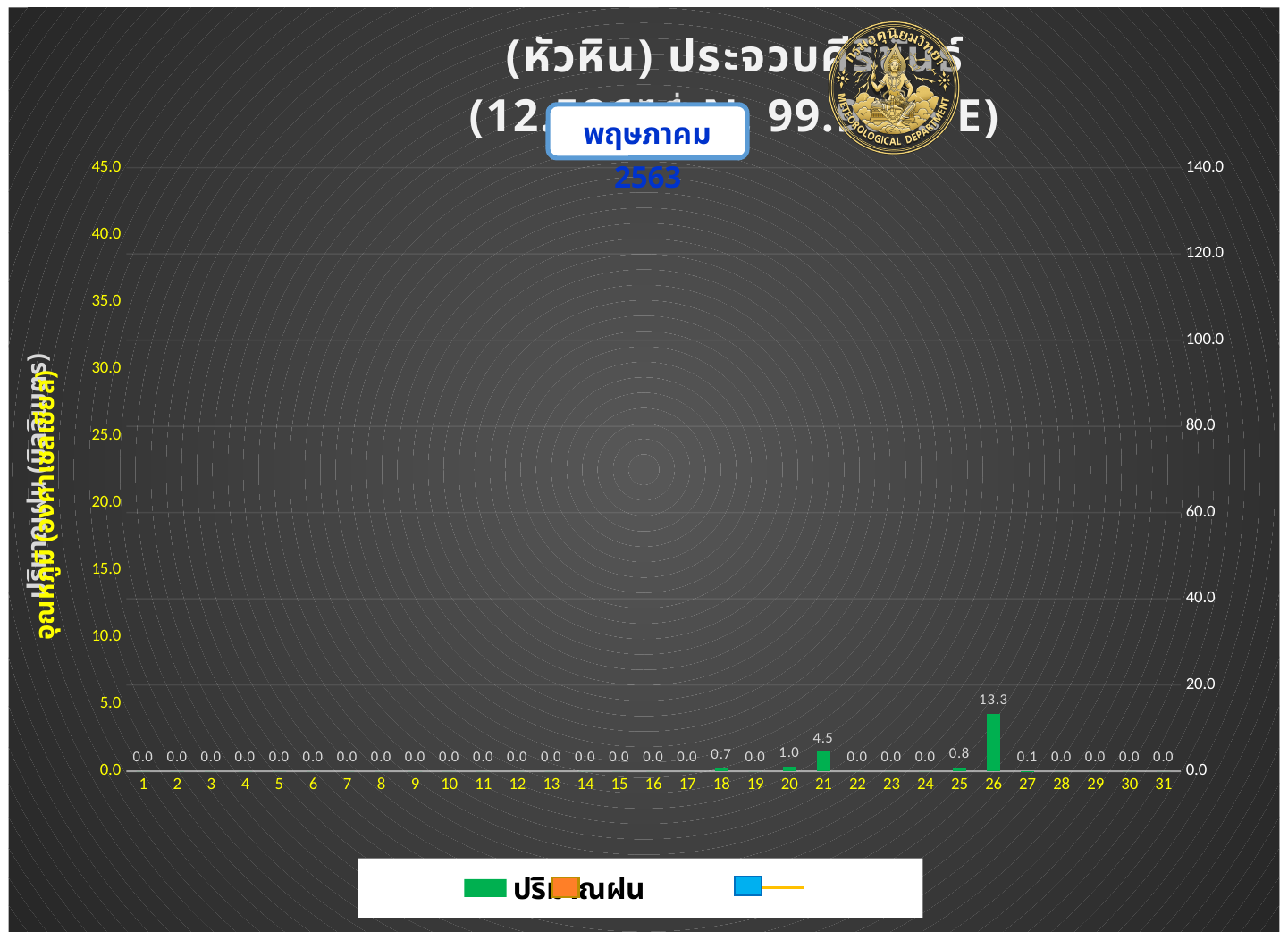
What is the rainfall value shown for day 21? 4.5 Which day has the highest rainfall value? 26 Which has the larger rainfall value, day 21 or day 25? Day 21 What is the rainfall value shown for day 18? 0.7 What kind of chart is shown on the slide? Bar chart What is the label of the green bar series in the legend? ปริมาณฝน What is the rainfall value shown for day 26? 13.3 How many days are shown along the x axis? 31 What is the difference between the rainfall values for day 26 and day 21? 8.8 What is the rainfall value shown for day 25? 0.8 What is the rainfall value shown for day 27? 0.1